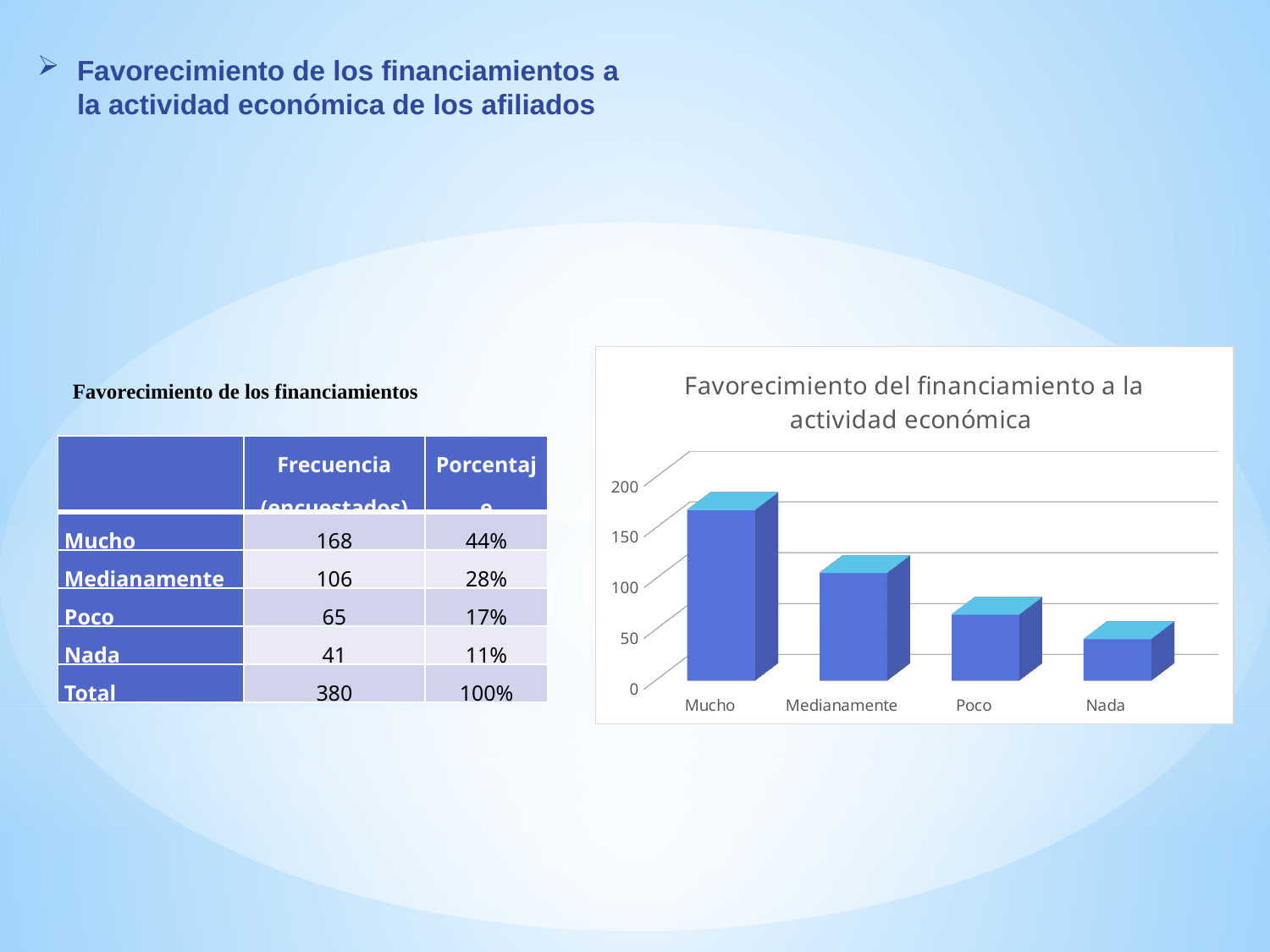
Which category has the highest bar in the chart? Mucho Which category has the lowest bar in the chart? Nada Is the value for Nada greater or less than 50? less Which is larger, the bar for Medianamente or the bar for Poco? Medianamente Is the value for Mucho greater or less than 150? greater What is the title of the chart? Favorecimiento del financiamiento a la actividad económica According to the slide, what is the frequency value plotted for Mucho? 168 Is the value for Medianamente greater or less than 150? less What type of chart is shown on the slide? bar chart Do the bar values rise or fall from left to right along the x axis? fall How many categories are plotted on the x axis of the chart? 4